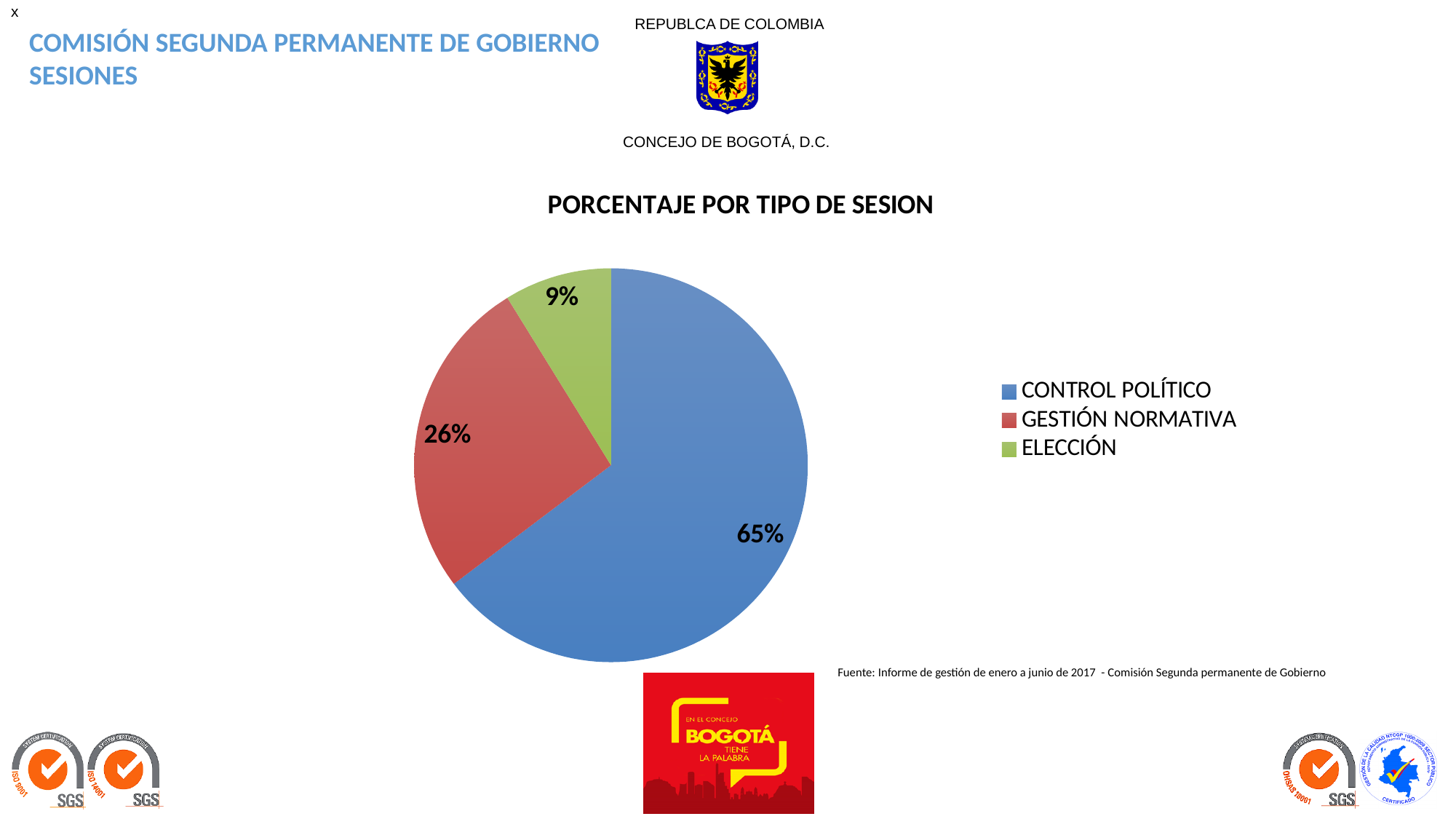
What share of the pie does ELECCIÓN represent? 9% Which colour represents ELECCIÓN in the chart? Green How many categories are shown in the pie chart? 3 What kind of chart is shown on the slide? Pie chart What is the difference in percentage points between CONTROL POLÍTICO and GESTIÓN NORMATIVA? 39 Which category has the largest slice of the pie? CONTROL POLÍTICO Which category has the smallest slice of the pie? ELECCIÓN What share of the pie does GESTIÓN NORMATIVA represent? 26% What is the title of the chart? PORCENTAJE POR TIPO DE SESION Which is larger, the slice for GESTIÓN NORMATIVA or the slice for ELECCIÓN? GESTIÓN NORMATIVA What share of the pie does CONTROL POLÍTICO represent? 65% What is the difference in percentage points between GESTIÓN NORMATIVA and ELECCIÓN? 17